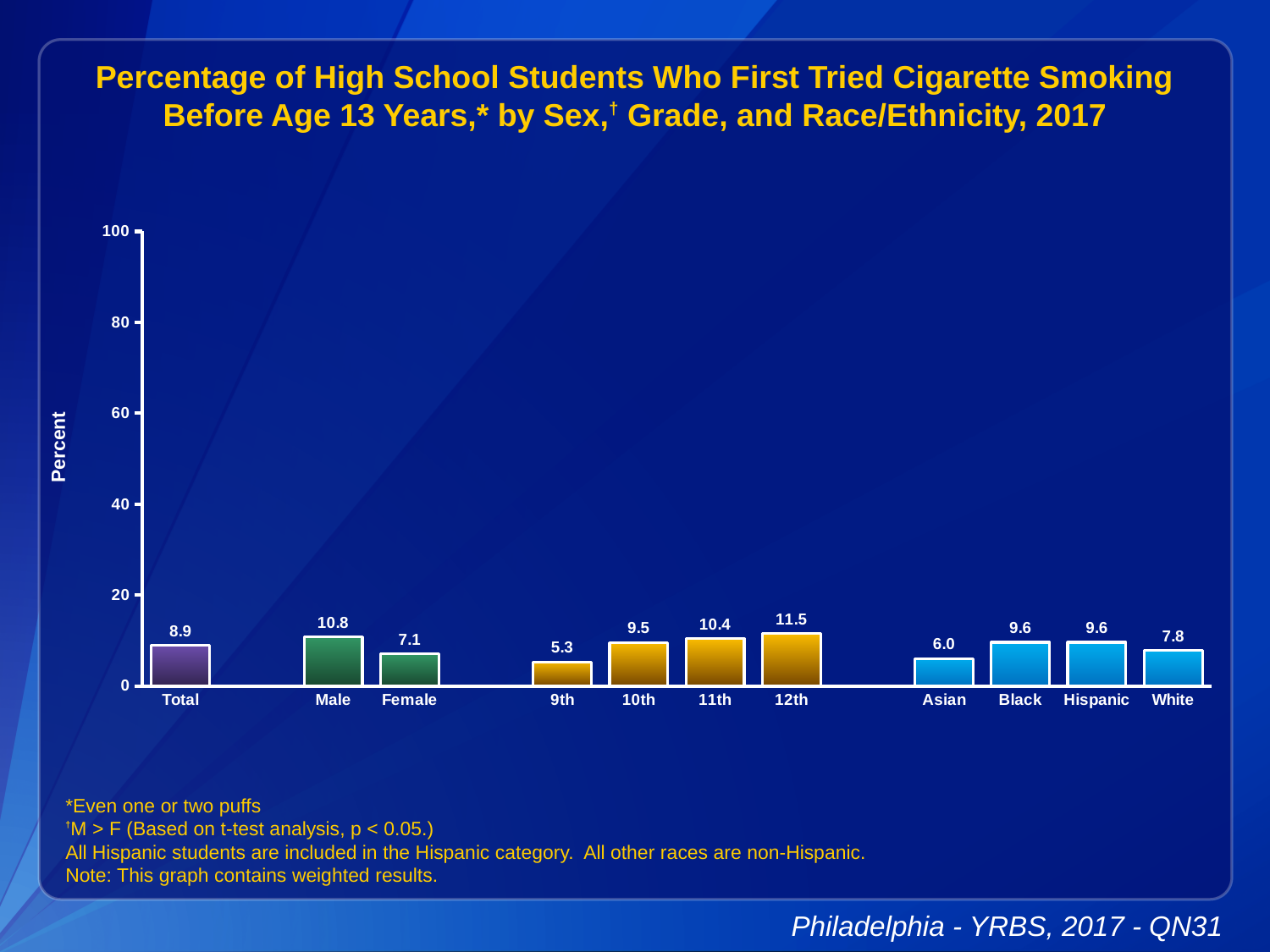
Which is larger, the value for Black or the value for White? Black What is the value for Asian? 6.0 Which category has the lowest value? 9th Which category has the highest value? 12th How many bars are shown in the chart? 11 What kind of chart is shown? bar chart What is the value for Total? 8.9 What is the value for 9th grade? 5.3 What is the value for Male? 10.8 Is the value for 12th grade greater or less than 20? less Do the values rise or fall from 9th grade to 12th grade? rise What is the difference between the Male and Female values? 3.7